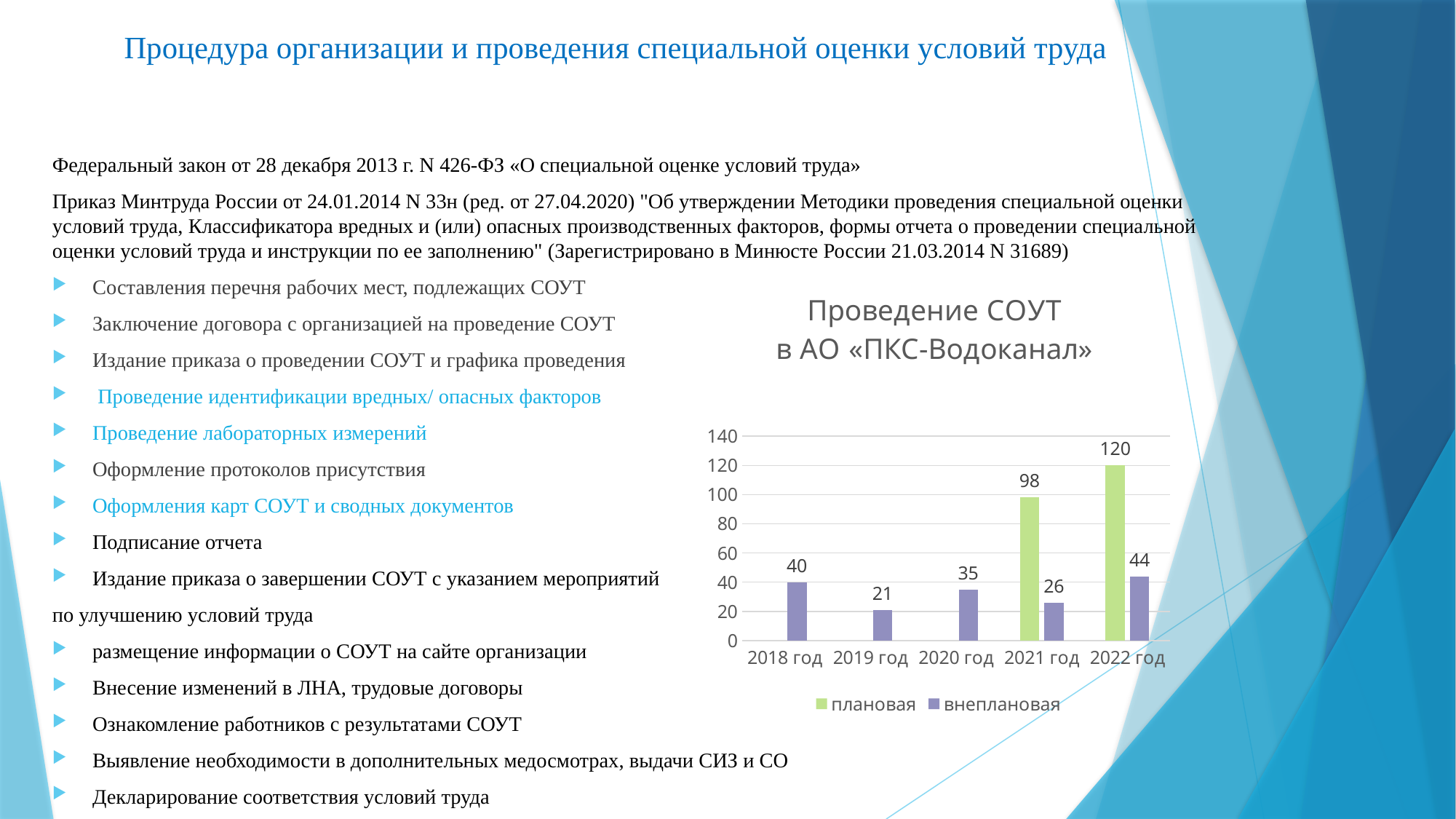
What is the difference between the плановая values for 2022 год and 2021 год? 22 What kind of chart is shown on the slide? bar chart Which is larger: the внеплановая value for 2018 год or for 2020 год? 2018 год Which year has the lowest внеплановая value? 2019 год What is the value for плановая in 2022 год? 120 How many series does the legend list? 2 What is the value for внеплановая in 2019 год? 21 What is the value for внеплановая in 2021 год? 26 How many years are shown on the x axis? 5 Which year has the highest внеплановая value? 2022 год What is the title of the chart? Проведение СОУТ в АО «ПКС-Водоканал» Is the плановая value for 2021 год greater or less than 100? less